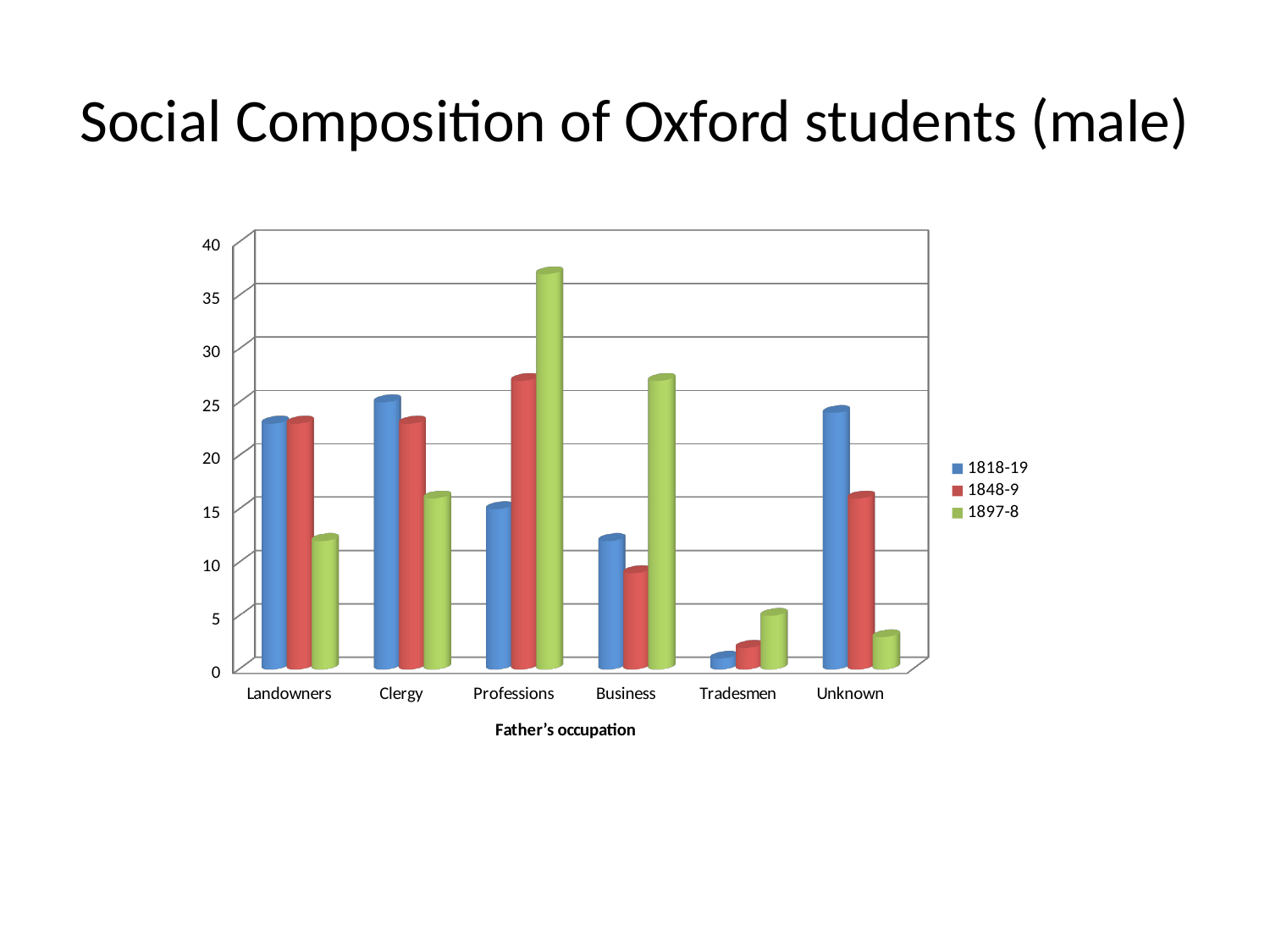
How many father's occupation categories are shown on the x axis? 6 Which category has the lowest value for the 1848-9 series? Tradesmen How many series does the legend list? 3 For Professions, which series has the larger value, 1818-19 or 1897-8? 1897-8 Is the value for Tradesmen in 1818-19 greater or less than 5? less Which category has the highest value for the 1897-8 series? Professions Which category has the lowest value for the 1818-19 series? Tradesmen Is the value for Unknown in 1818-19 greater or less than 20? greater What kind of chart is shown on the slide? bar chart Is the value for Professions in 1897-8 greater or less than 30? greater For Unknown, which series has the larger value, 1818-19 or 1897-8? 1818-19 What is the title of the x axis? Father's occupation